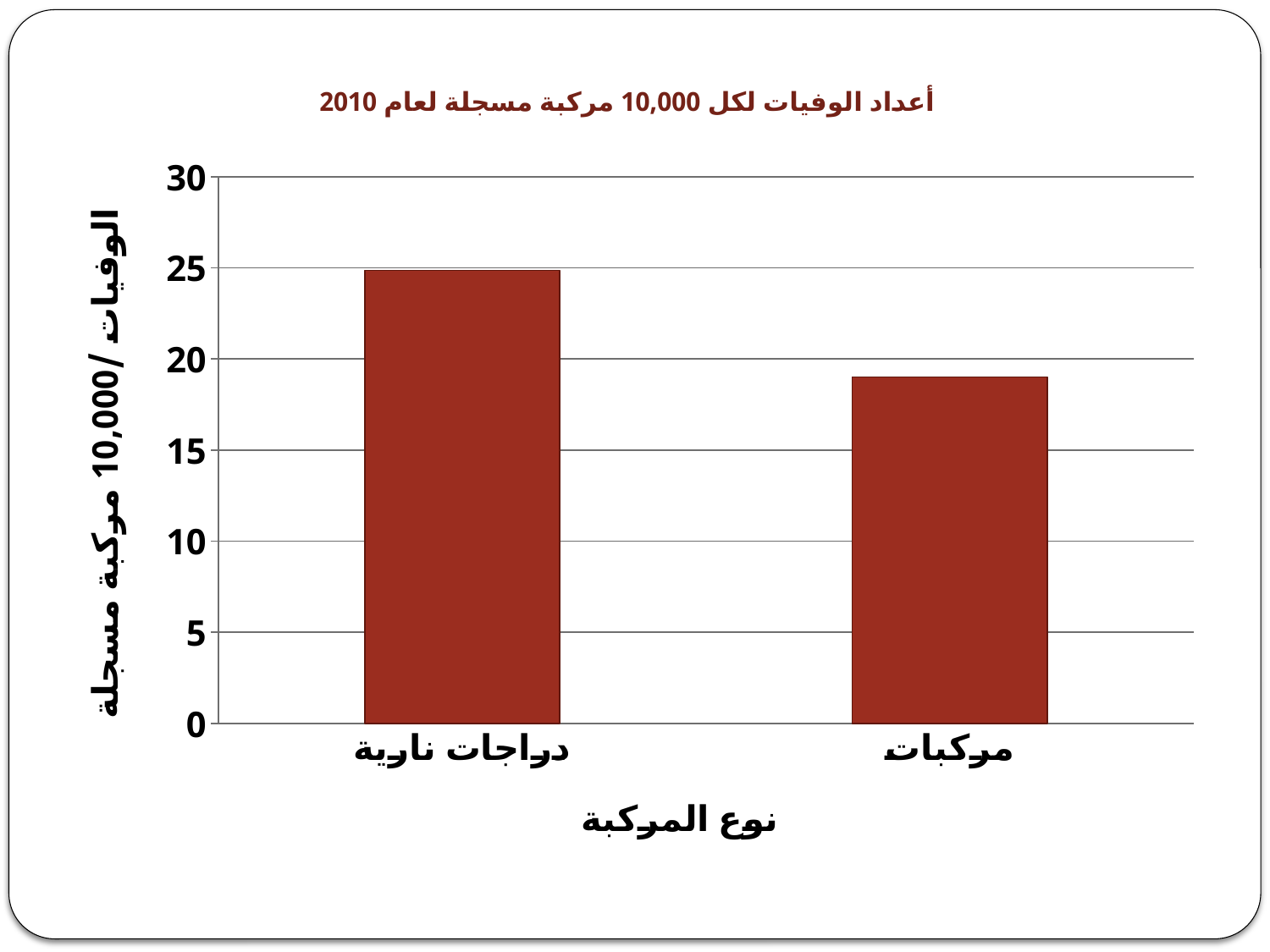
Which is larger, the value for دراجات نارية or the value for مركبات? دراجات نارية Is the value for مركبات greater or less than 20? less Is the value for دراجات نارية greater or less than 20? greater Is the value for دراجات نارية greater or less than 30? less How many categories are shown on the x axis of the chart? 2 What kind of chart is shown on the slide? bar chart Which vehicle type has the lowest number of deaths per 10,000 registered vehicles? مركبات Which vehicle type has the highest number of deaths per 10,000 registered vehicles? دراجات نارية What is the label of the x axis of the chart? نوع المركبة What is the title of the chart? أعداد الوفيات لكل 10,000 مركبة مسجلة لعام 2010 What is the highest value shown on the y axis of the chart? 30